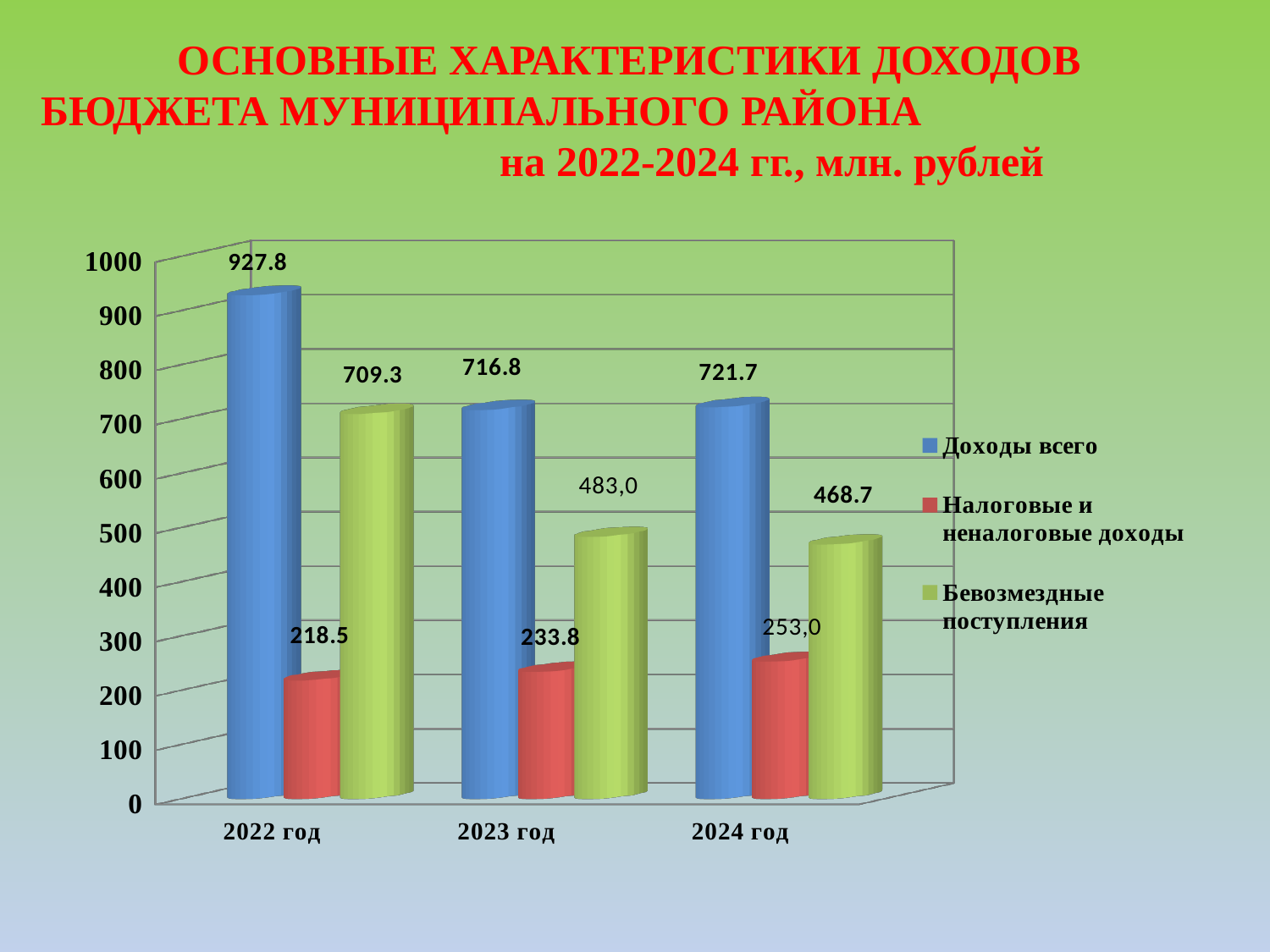
How many series does the legend list? 3 What is the value of Налоговые и неналоговые доходы for 2024 год? 253,0 What kind of chart is shown on the slide? bar chart Which is larger: Безвозмездные поступления in 2023 год or in 2024 год? 2023 год In which year is Налоговые и неналоговые доходы the lowest? 2022 год How many years are shown on the x axis? 3 Does Налоговые и неналоговые доходы rise or fall from 2022 год to 2024 год? rise Is the value of Безвозмездные поступления for 2022 год greater or less than 700? greater What is the difference between Доходы всего in 2022 год and 2023 год? 211.0 What is the value of Доходы всего for 2022 год? 927.8 What is the value of Безвозмездные поступления for 2023 год? 483,0 In which year is Доходы всего the highest? 2022 год